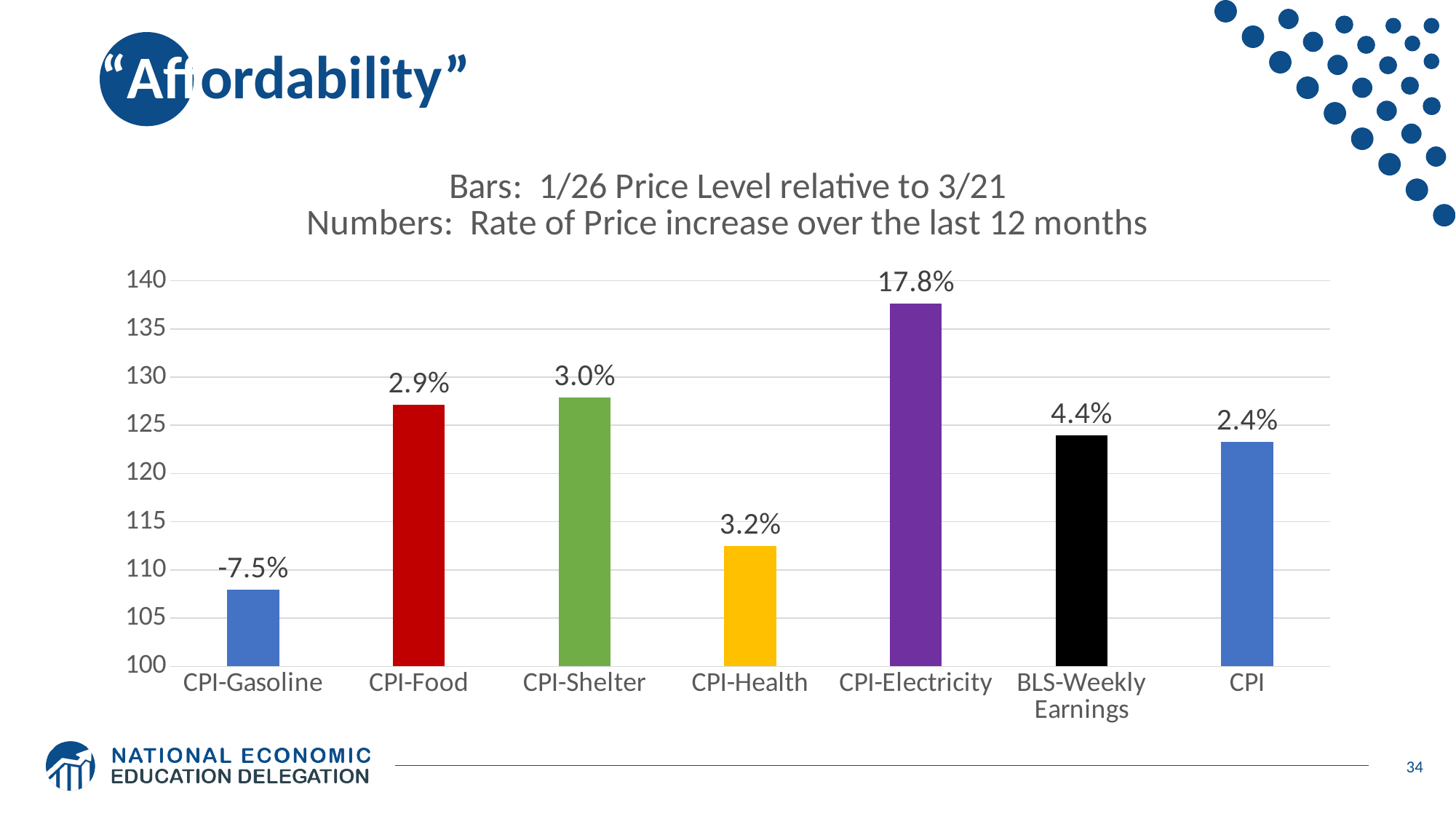
What is the rate of price increase over the last 12 months shown for CPI-Health? 3.2% Which category has the lowest bar (price level relative to 3/21)? CPI-Gasoline What is the rate of price increase over the last 12 months shown for CPI-Gasoline? -7.5% What kind of chart is shown on the slide? Bar chart What is the rate of price increase over the last 12 months shown for CPI-Electricity? 17.8% Which has a higher 12-month rate of price increase, BLS-Weekly Earnings or CPI? BLS-Weekly Earnings Which category has the highest 12-month rate of price increase? CPI-Electricity Is the bar for CPI-Gasoline greater or less than 110? less Is the bar for CPI-Electricity greater or less than 135? greater What is the difference between the 12-month rate of price increase for CPI-Electricity and for CPI? 15.4 percentage points How many categories are shown on the x axis? 7 What is the rate of price increase over the last 12 months shown for BLS-Weekly Earnings? 4.4%